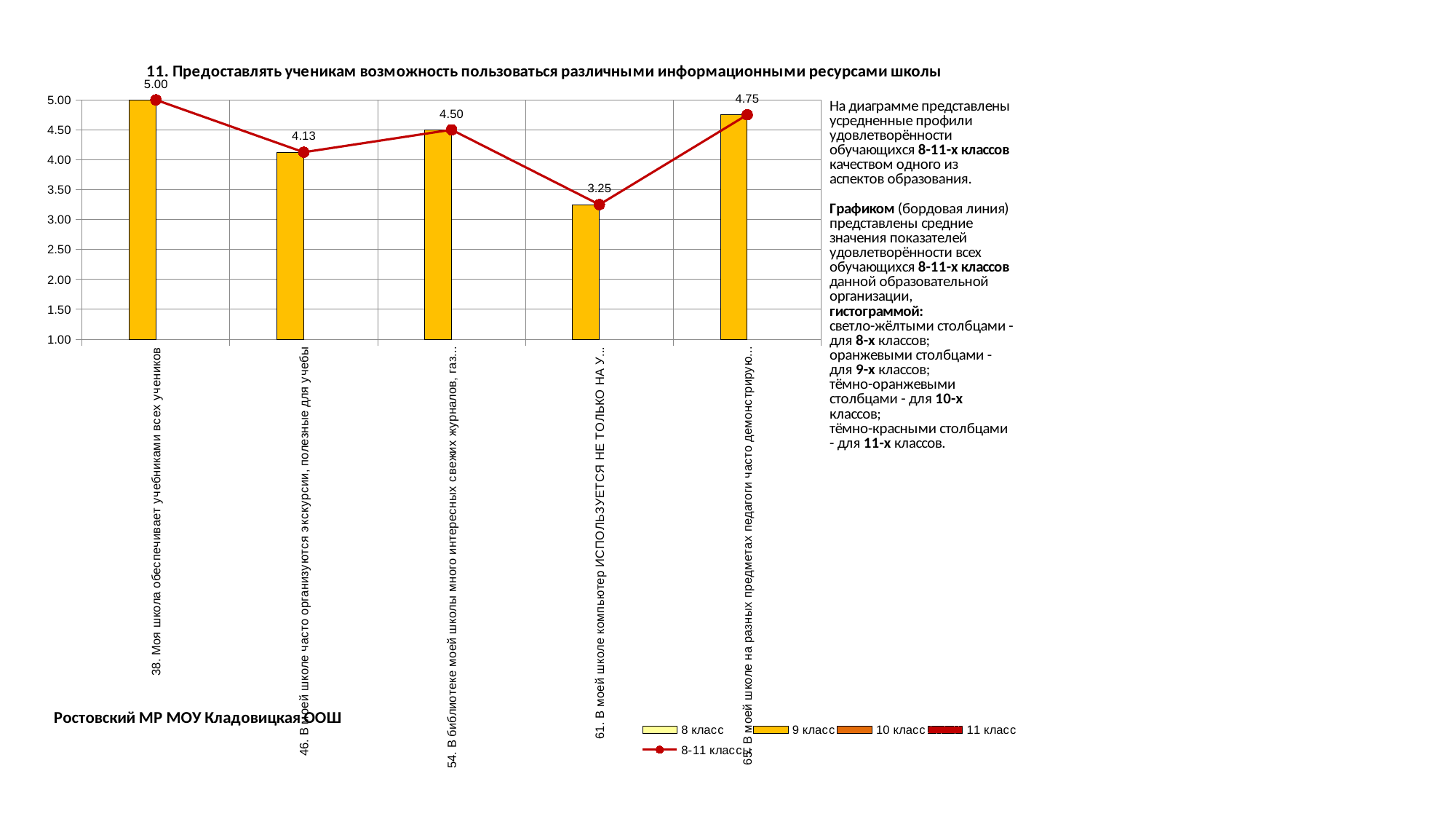
What is the difference between the values for statement 38 and statement 61? 1.75 How many statements (categories) are plotted on the x axis? 5 Which statement has the highest value on the chart? 38. Моя школа обеспечивает учебниками всех учеников Which has the larger value: statement 46 or statement 54? 54. В библиотеке моей школы много интересных свежих журналов, газ... What value is labelled for statement 38 ("Моя школа обеспечивает учебниками всех учеников")? 5.00 What kind of chart is shown on the slide? Combined bar and line chart What value is labelled for statement 61 ("В моей школе компьютер ИСПОЛЬЗУЕТСЯ НЕ ТОЛЬКО НА У...")? 3.25 How many series does the legend list? 5 Which statement has the lowest value on the chart? 61. В моей школе компьютер ИСПОЛЬЗУЕТСЯ НЕ ТОЛЬКО НА У...